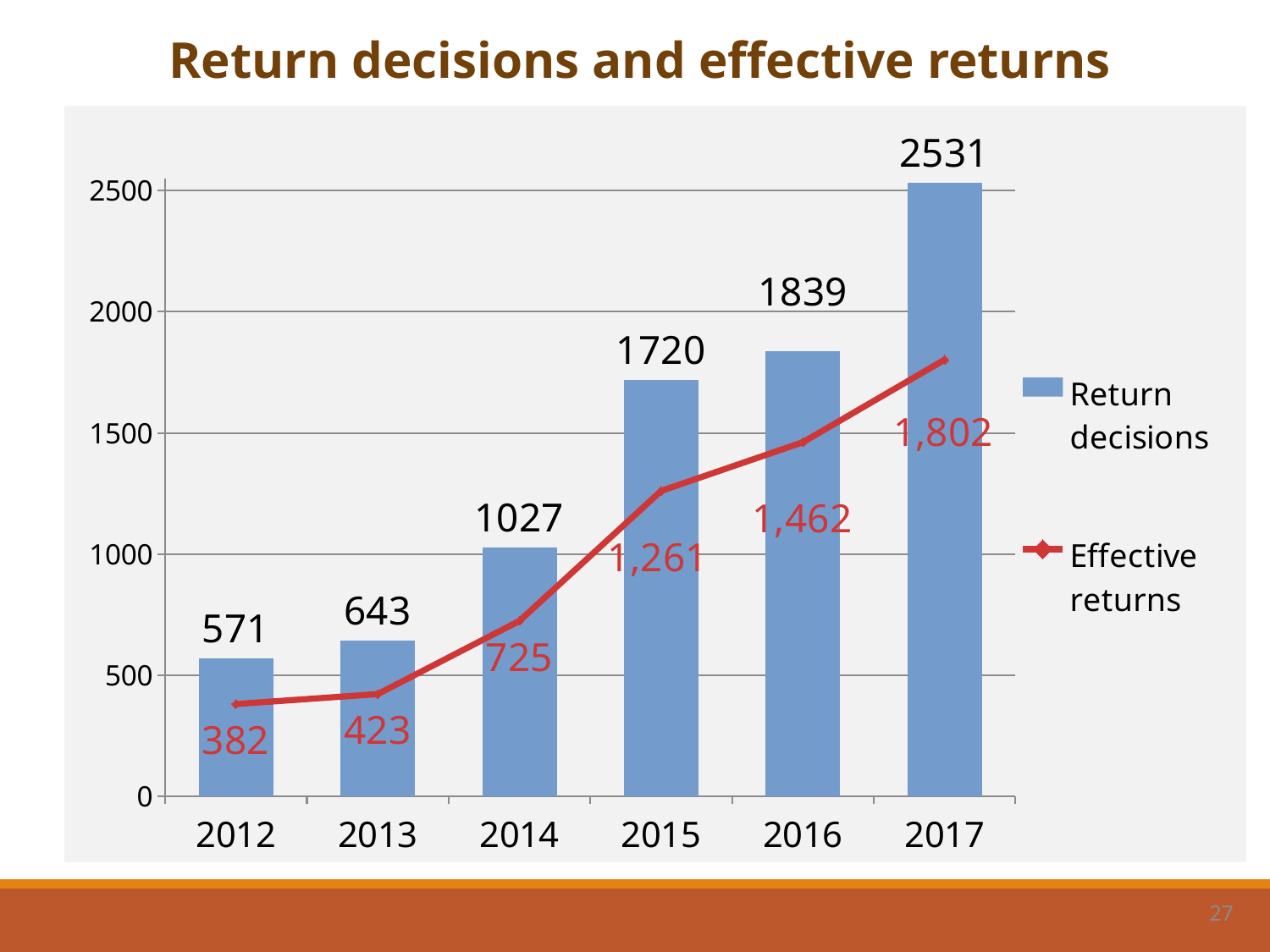
Do Effective returns rise or fall from 2012 to 2017? Rise Which year has the highest number of Return decisions? 2017 How many series does the legend list? 2 What is the difference between Return decisions and Effective returns in 2017? 729 Which is larger: Return decisions in 2014 or Effective returns in 2015? Effective returns in 2015 Which year has the lowest number of Effective returns? 2012 What is the value of Return decisions in 2015? 1720 What is the difference in Return decisions between 2016 and 2015? 119 How many years are shown on the x axis? 6 What is the value of Effective returns in 2012? 382 What is the value of Effective returns in 2016? 1,462 What kind of chart is used for the Return decisions series? Bar chart